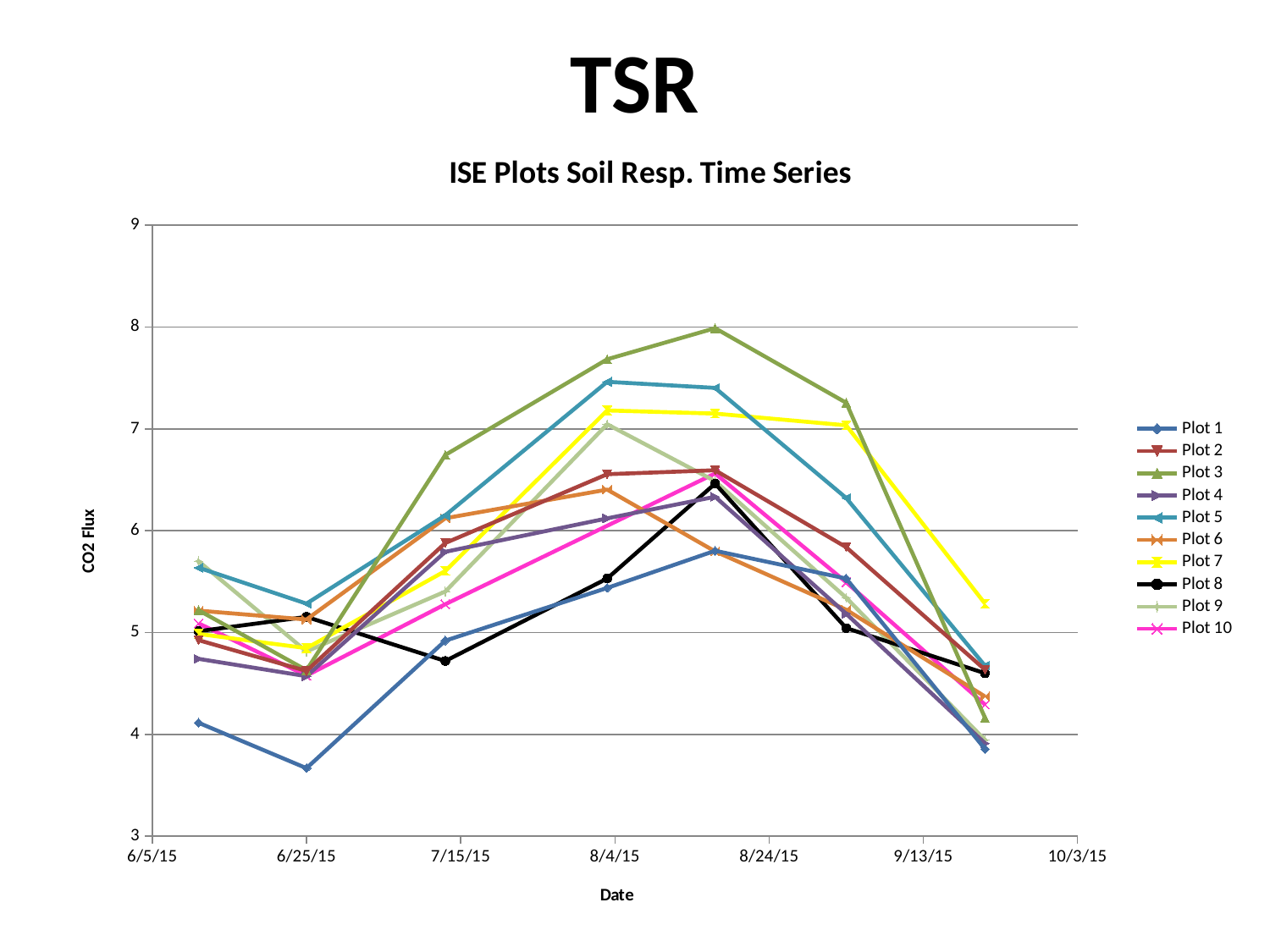
Is the highest value of Plot 3 greater or less than 7? greater Is the value for Plot 5 on 8/4/15 greater or less than 7? greater How many data points does each series have? 7 Is the value for Plot 1 on 6/25/15 greater or less than 4? less What is the title of the chart? ISE Plots Soil Resp. Time Series What is the label on the vertical axis? CO2 Flux How many series does the legend list? 10 Which plot reaches the highest CO2 Flux value anywhere on the chart? Plot 3 On 6/25/15, which is larger, Plot 1 or Plot 5? Plot 5 On 8/4/15, which is larger, Plot 3 or Plot 8? Plot 3 What kind of chart is shown on the slide? line chart Which plot has the lowest CO2 Flux value anywhere on the chart? Plot 1